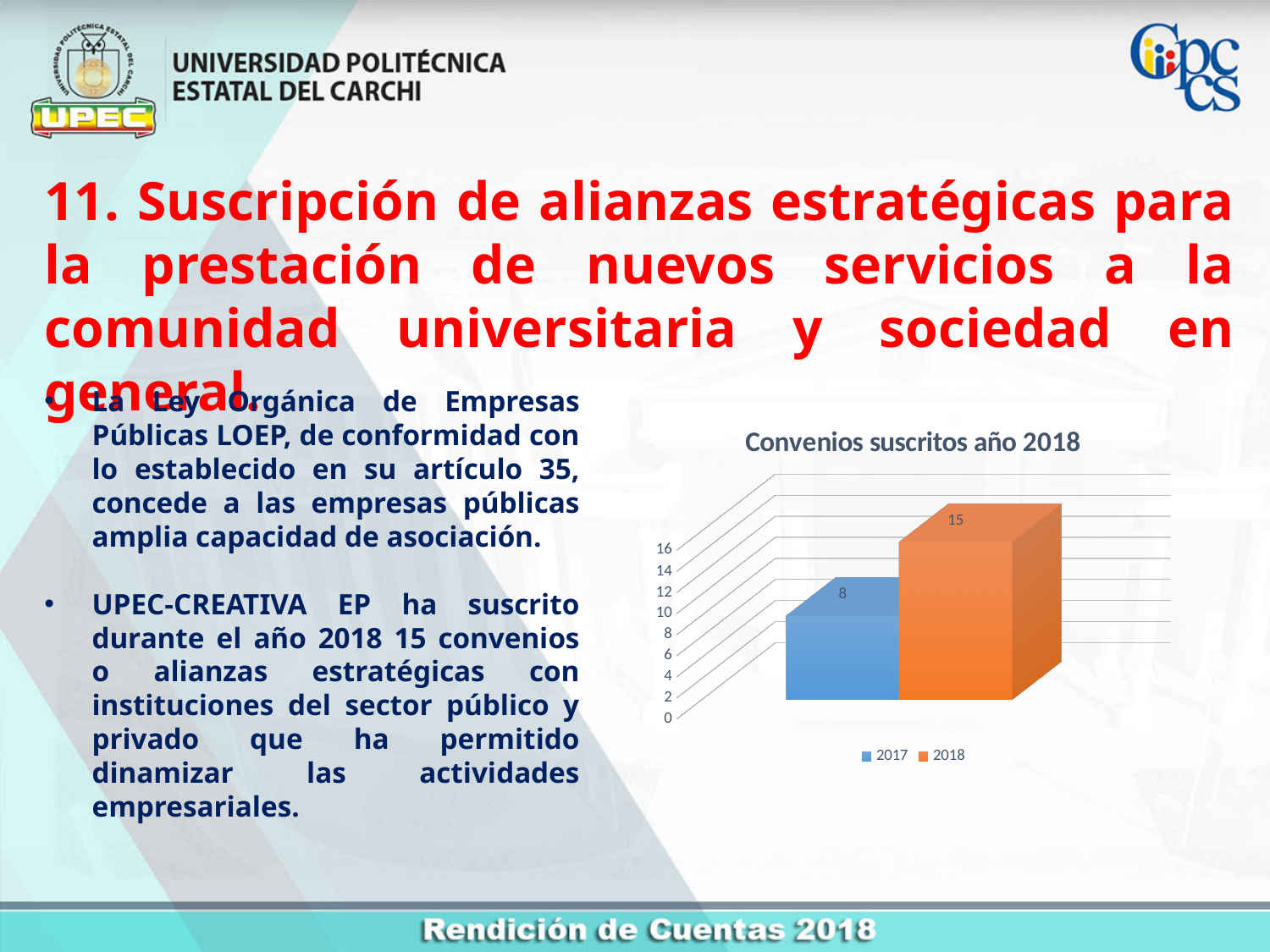
What is the title of the chart? Convenios suscritos año 2018 What colour is the bar for 2018? Orange What is the difference between the values for 2018 and 2017? 7 What is the value for 2018 in the chart? 15 Is the value for 2018 greater or less than 12? greater Is the value for 2018 larger than the value for 2017? Yes Which year has the higher value in the chart? 2018 Is the value for 2017 greater or less than 10? less Which year has the lower value in the chart? 2017 What kind of chart is shown on the slide? Bar chart What is the value for 2017 in the chart? 8 How many series does the legend list? 2